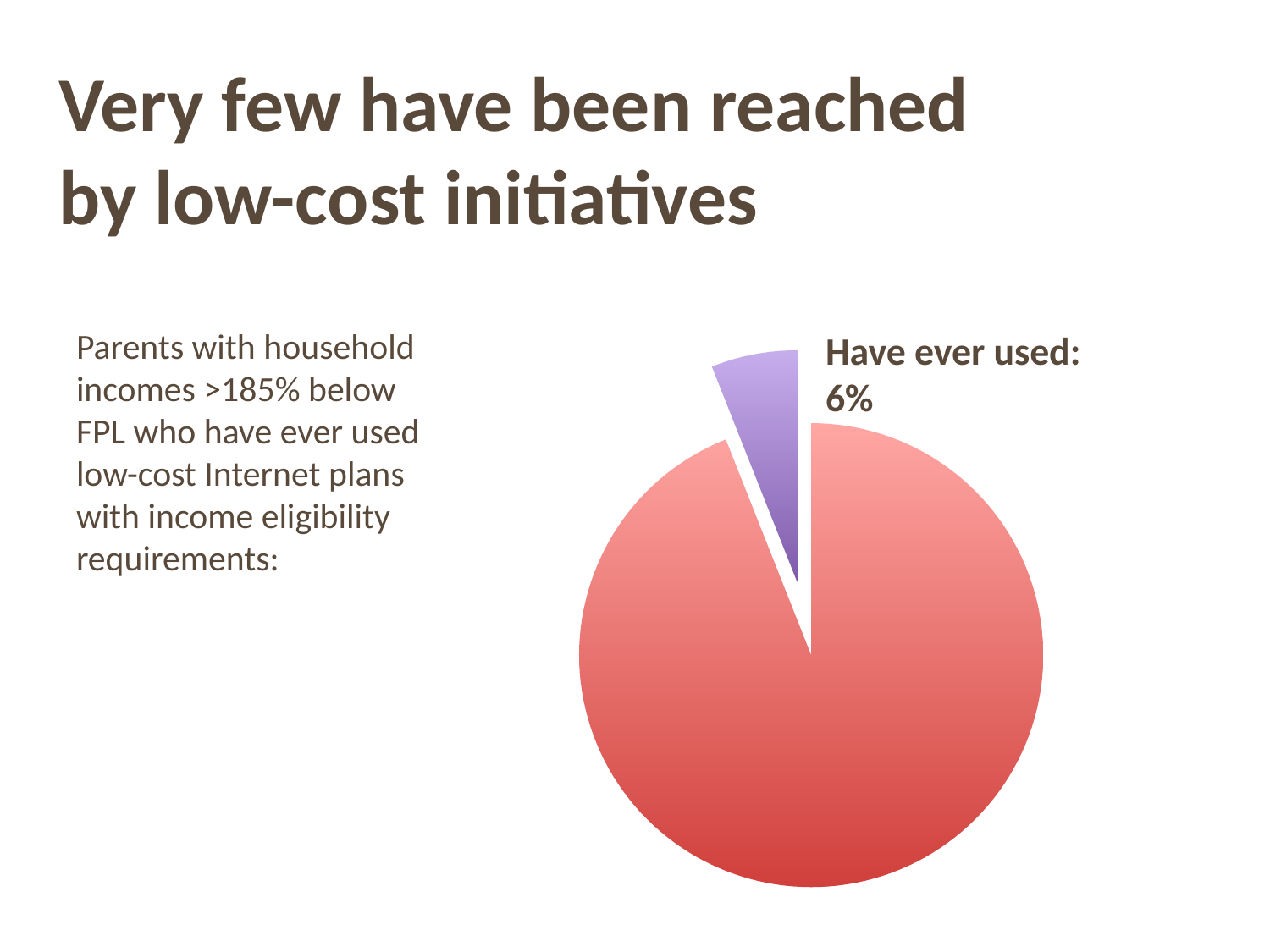
What share of the pie is labelled "Have ever used"? 6% Is the share for "Have ever used" greater or less than 10%? less Which slice of the pie is the smallest? Have ever used Which slice is larger, the purple "Have ever used" slice or the red slice? the red slice Is the red slice greater or less than half of the pie? greater What kind of chart is shown on the slide? pie chart How many slices does the pie chart have? 2 What is the title of the slide containing the pie chart? Very few have been reached by low-cost initiatives What colour is the "Have ever used" slice? purple